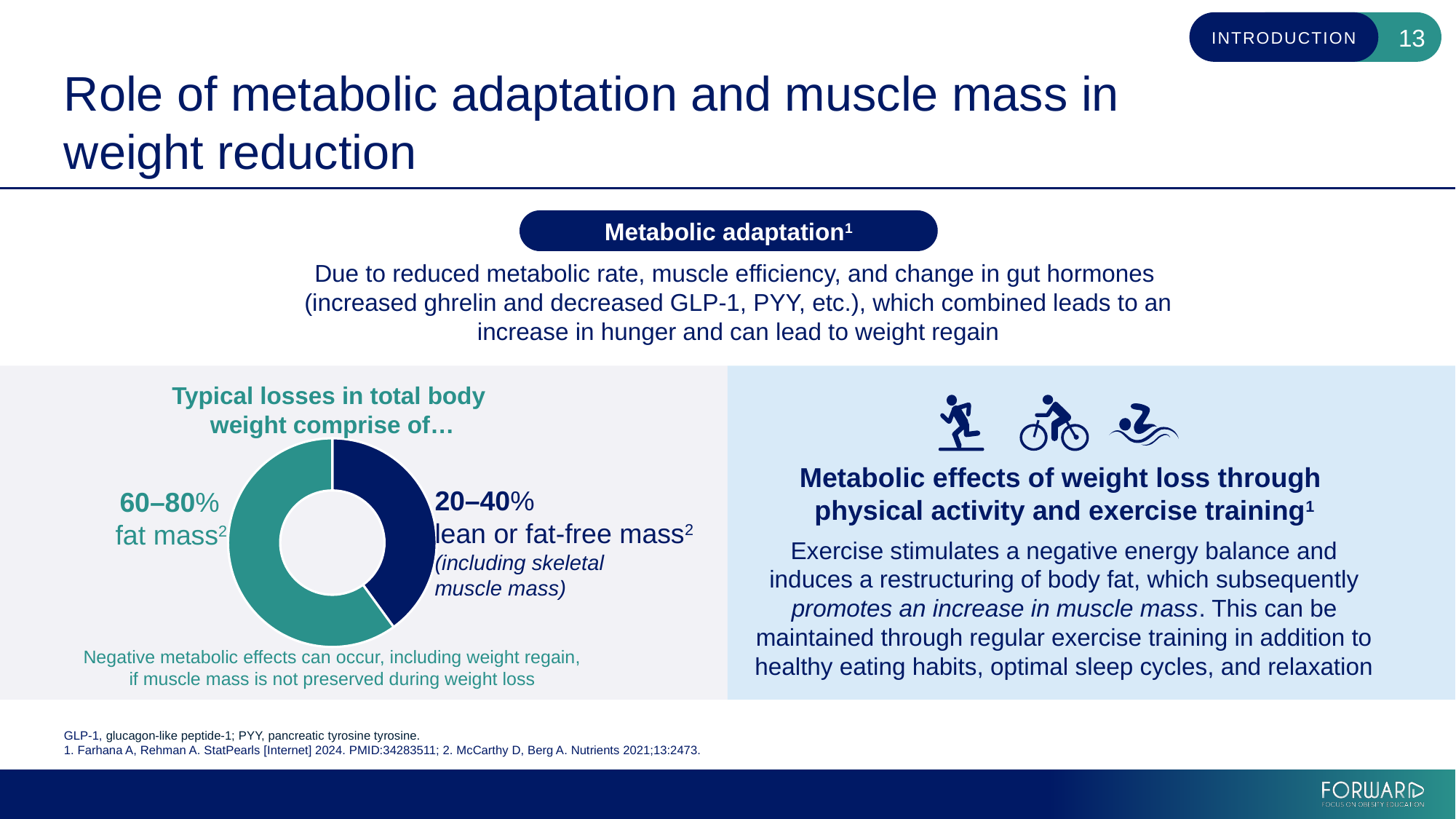
What share of typical total body weight loss is fat mass, according to the chart? 60–80% Which segment of the donut chart is the largest? fat mass Which segment of the donut chart is the smallest? lean or fat-free mass Which accounts for a larger share of typical weight loss in the chart: fat mass or lean or fat-free mass? fat mass What colour is the lean or fat-free mass segment of the donut chart? dark blue Is the share for fat mass in the donut chart greater or less than 50%? greater How many segments does the donut chart have? 2 What is the title of the donut chart? Typical losses in total body weight comprise of… What kind of chart is shown on the slide? donut chart Is the share for lean or fat-free mass in the donut chart greater or less than 50%? less What share of typical total body weight loss is lean or fat-free mass, according to the chart? 20–40%